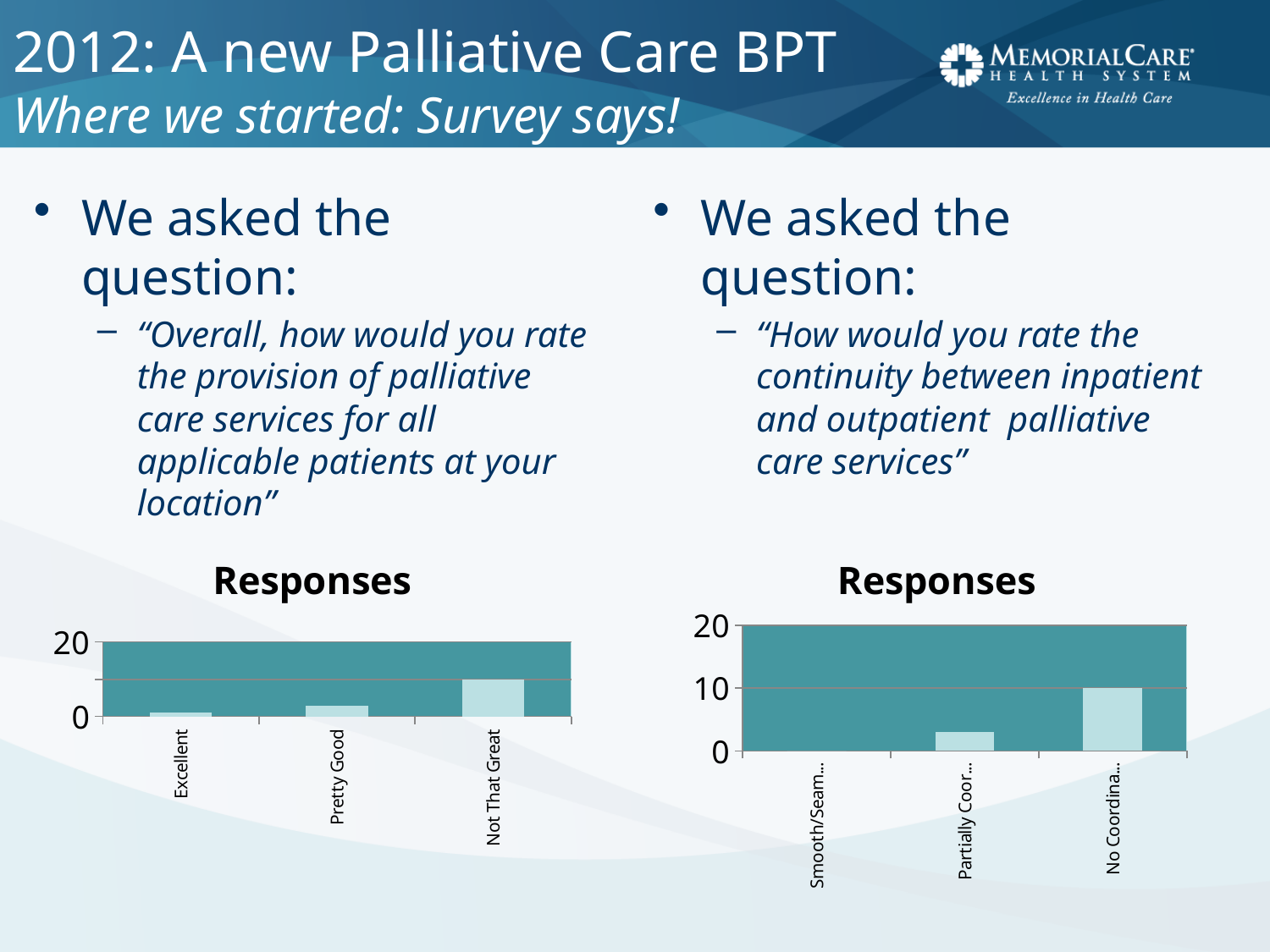
On the left chart, is the value for Not That Great greater or less than 20? less What is the title of the right chart? Responses On the left chart, which category has the highest value? Not That Great How many categories are shown on the right chart? 3 What type of chart is the left chart? bar chart On the right chart, which is larger, the value for Partially Coor... or the value for No Coordina...? No Coordina... On the right chart, which category has the highest value? No Coordina... On the left chart, is the value for Pretty Good greater or less than 10? less On the right chart, is the value for Partially Coor... greater or less than 10? less On the left chart, which category has the lowest value? Excellent On the left chart, which is larger, the value for Pretty Good or the value for Not That Great? Not That Great How many categories are shown on the left chart? 3